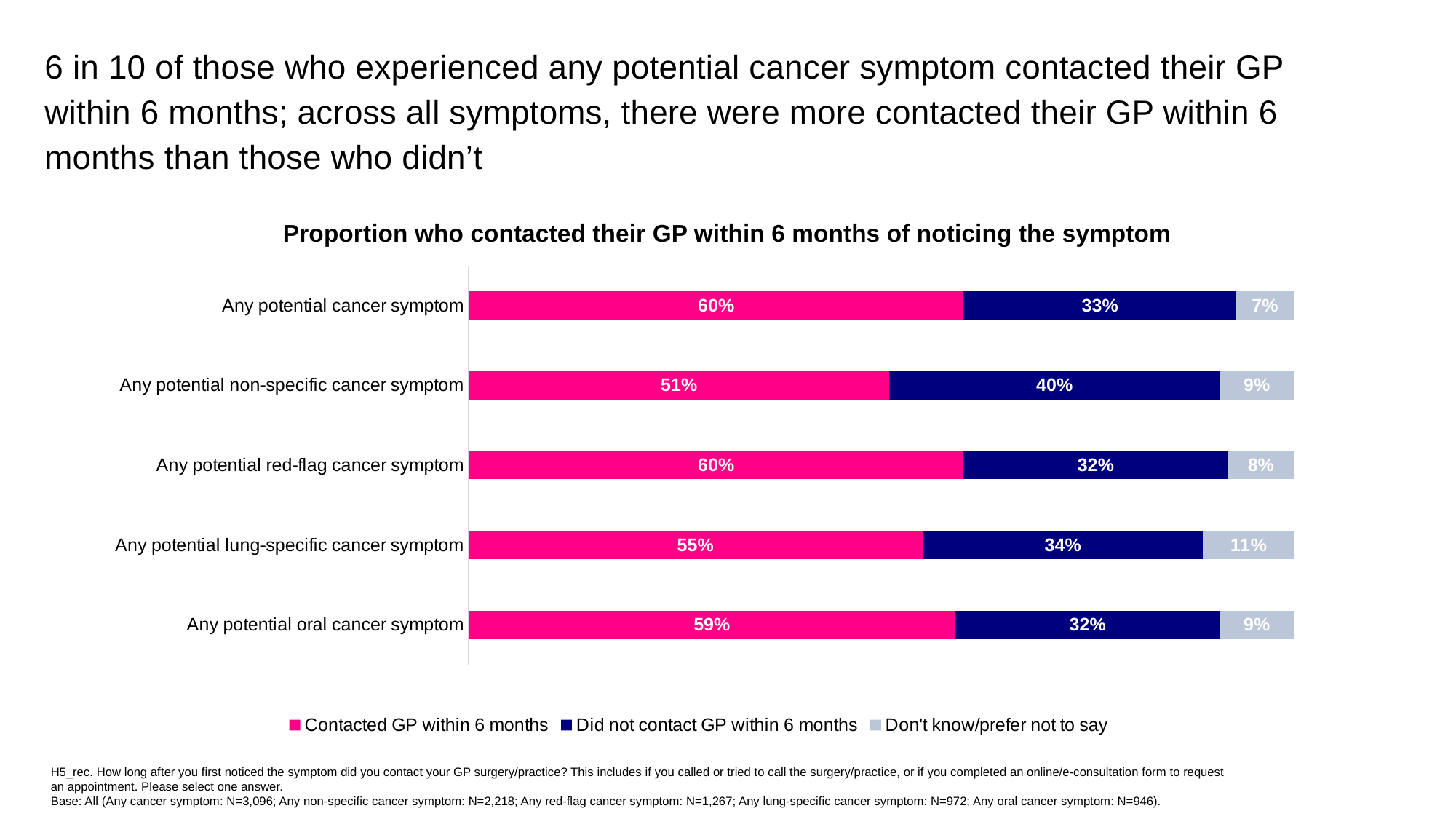
What percentage of those with any potential cancer symptom contacted their GP within 6 months? 60% What percentage of those with any potential non-specific cancer symptom did not contact their GP within 6 months? 40% How many symptom categories are shown in the chart? 5 Which symptom category has the highest 'Don't know/prefer not to say' proportion? Any potential lung-specific cancer symptom What percentage of those with any potential oral cancer symptom contacted their GP within 6 months? 59% Which symptom category has the lowest proportion who contacted their GP within 6 months? Any potential non-specific cancer symptom What type of chart is shown on the slide? Stacked bar chart What is the title of the chart? Proportion who contacted their GP within 6 months of noticing the symptom What is the difference between the 'Contacted GP within 6 months' and 'Did not contact GP within 6 months' values for any potential red-flag cancer symptom? 28 percentage points What is the 'Don't know/prefer not to say' value for any potential lung-specific cancer symptom? 11% Which is larger for any potential lung-specific cancer symptom: the proportion who contacted their GP within 6 months or the proportion who did not? Contacted GP within 6 months How many series does the legend list? 3